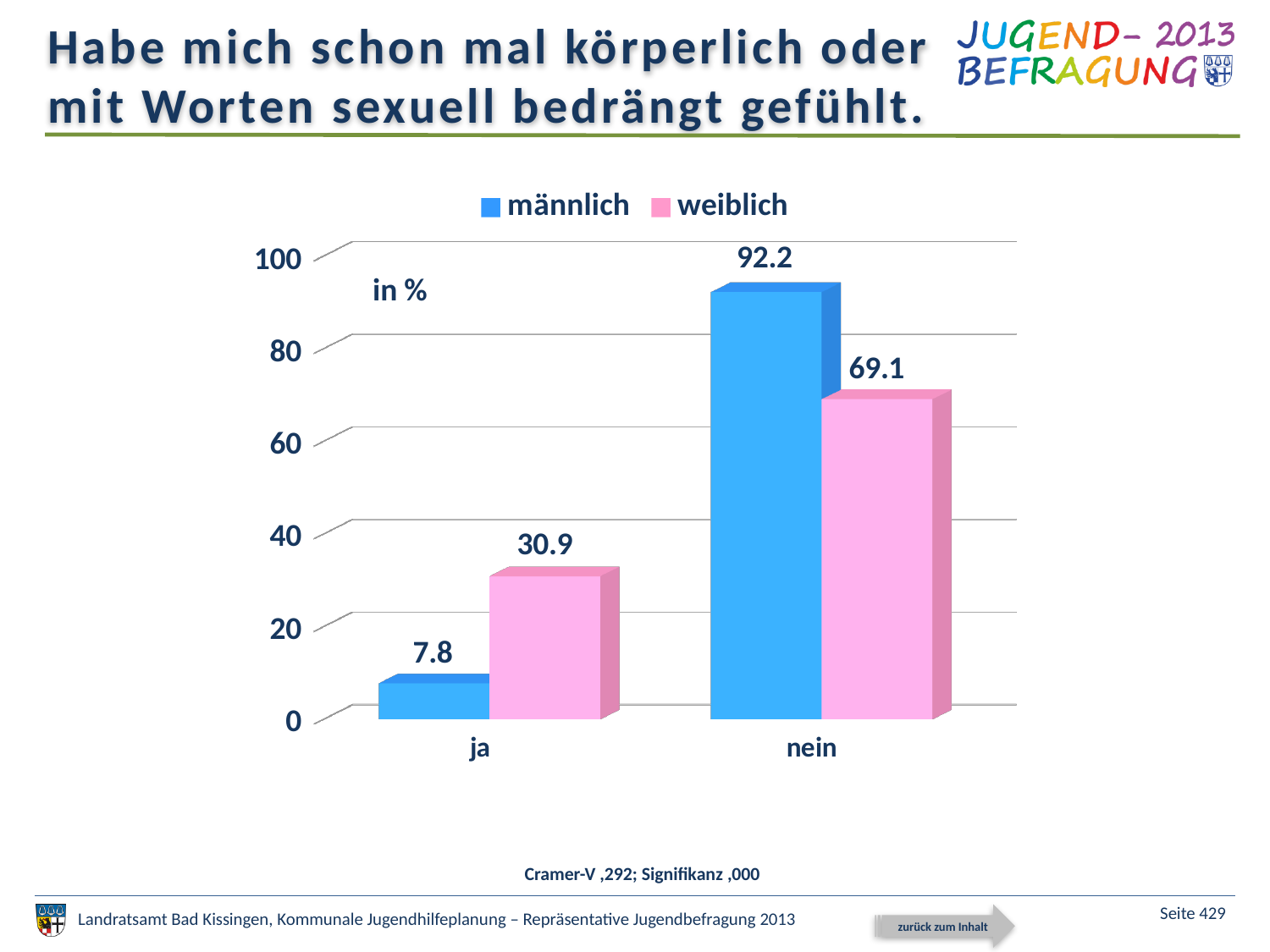
What is the difference between the weiblich and männlich values in the ja category? 23.1 Which bar has the highest value on the chart? männlich, nein Which bar has the lowest value on the chart? männlich, ja How many categories are shown on the x axis? 2 What is the value for weiblich in the nein category? 69.1 What is the value for männlich in the ja category? 7.8 Which is larger in the nein category, männlich or weiblich? männlich What kind of chart is shown on the slide? bar chart What is the value for weiblich in the ja category? 30.9 What is the difference between the männlich and weiblich values in the nein category? 23.1 What is the value for männlich in the nein category? 92.2 How many series does the legend list? 2